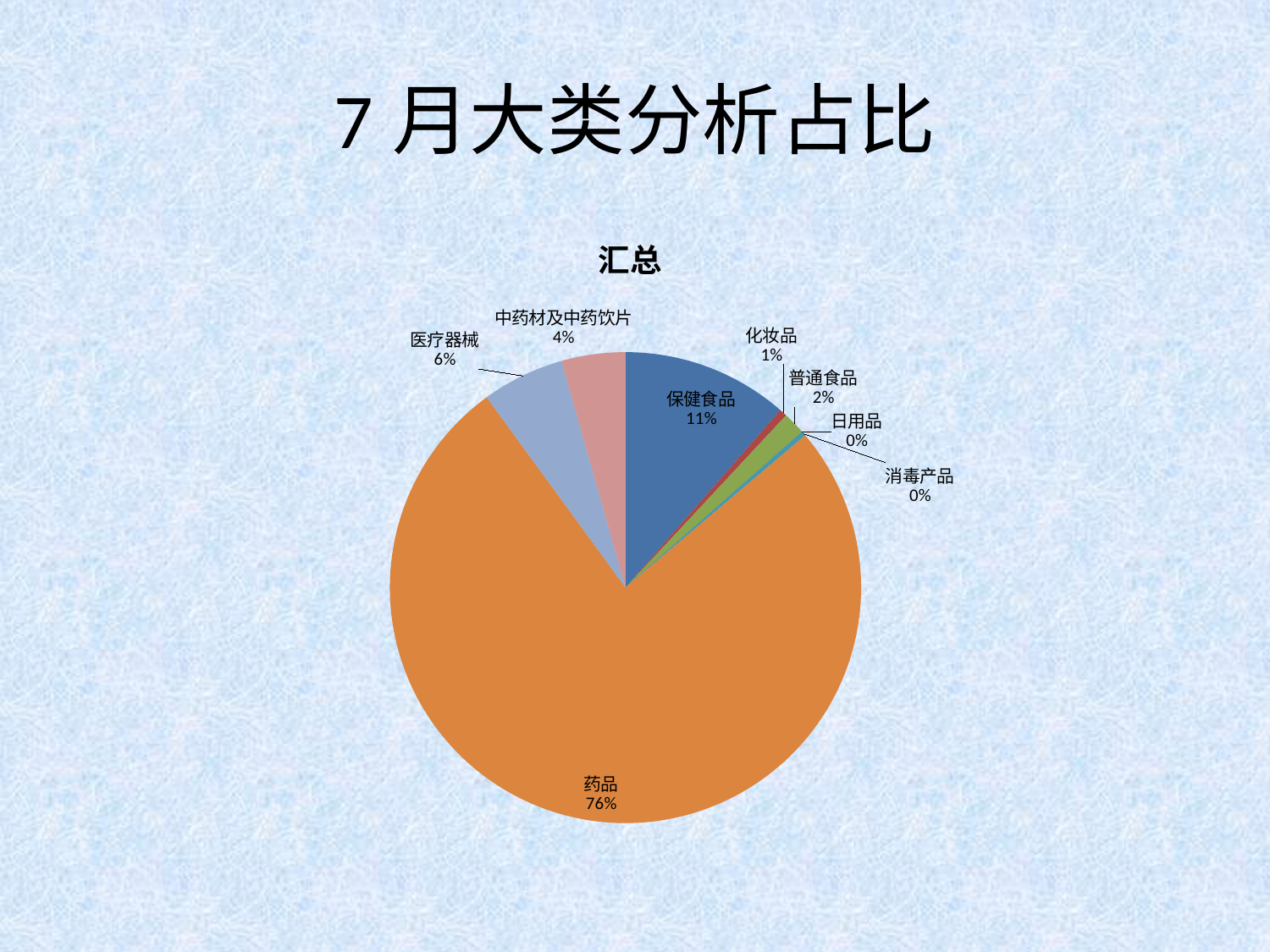
What share of the pie does 保健食品 take? 11% What is the value shown for 普通食品? 2% How many categories are shown in the pie chart? 8 What is the value shown for 中药材及中药饮片? 4% What kind of chart is shown on the slide? pie chart What is the chart's title? 汇总 What share of the pie does 药品 take? 76% What is the value shown for 化妆品? 1% Which category has the largest slice? 药品 Which is larger, the share of 医疗器械 or the share of 中药材及中药饮片? 医疗器械 What is the difference between the shares of 药品 and 保健食品? 65% What is the value shown for 医疗器械? 6%